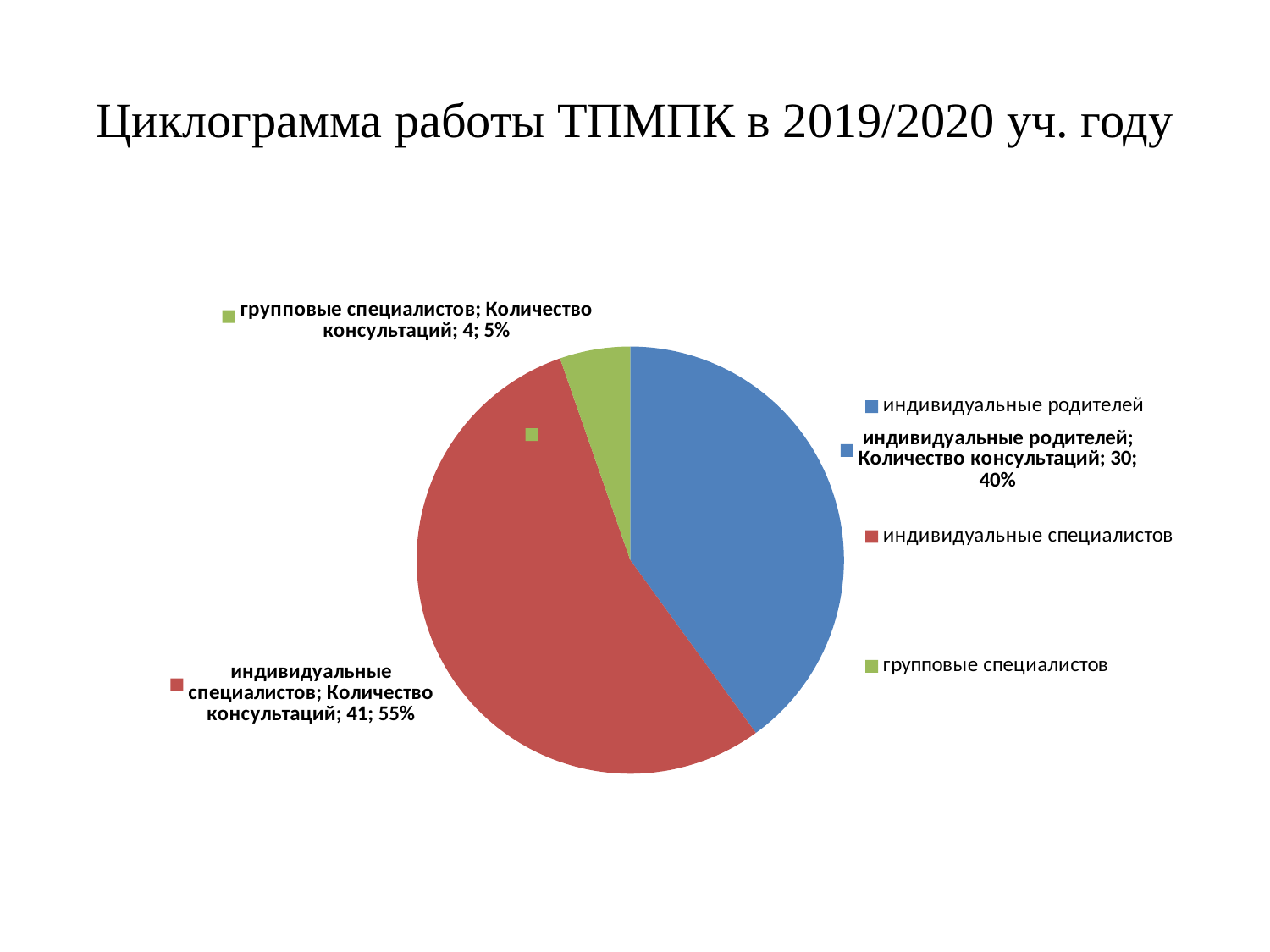
How many consultations are shown for индивидуальные специалистов? 41 How many consultations are shown for групповые специалистов? 4 What share of the pie does групповые специалистов take? 5% What is the title of the slide? Циклограмма работы ТПМПК в 2019/2020 уч. году What share of the pie does индивидуальные родителей take? 40% How many consultations are shown for индивидуальные родителей? 30 What share of the pie does индивидуальные специалистов take? 55% Which category has the largest slice of the pie? индивидуальные специалистов Which category has the smallest slice of the pie? групповые специалистов What kind of chart is shown on the slide? pie chart How many categories does the pie chart have? 3 What is the difference in consultations between индивидуальные специалистов and индивидуальные родителей? 11